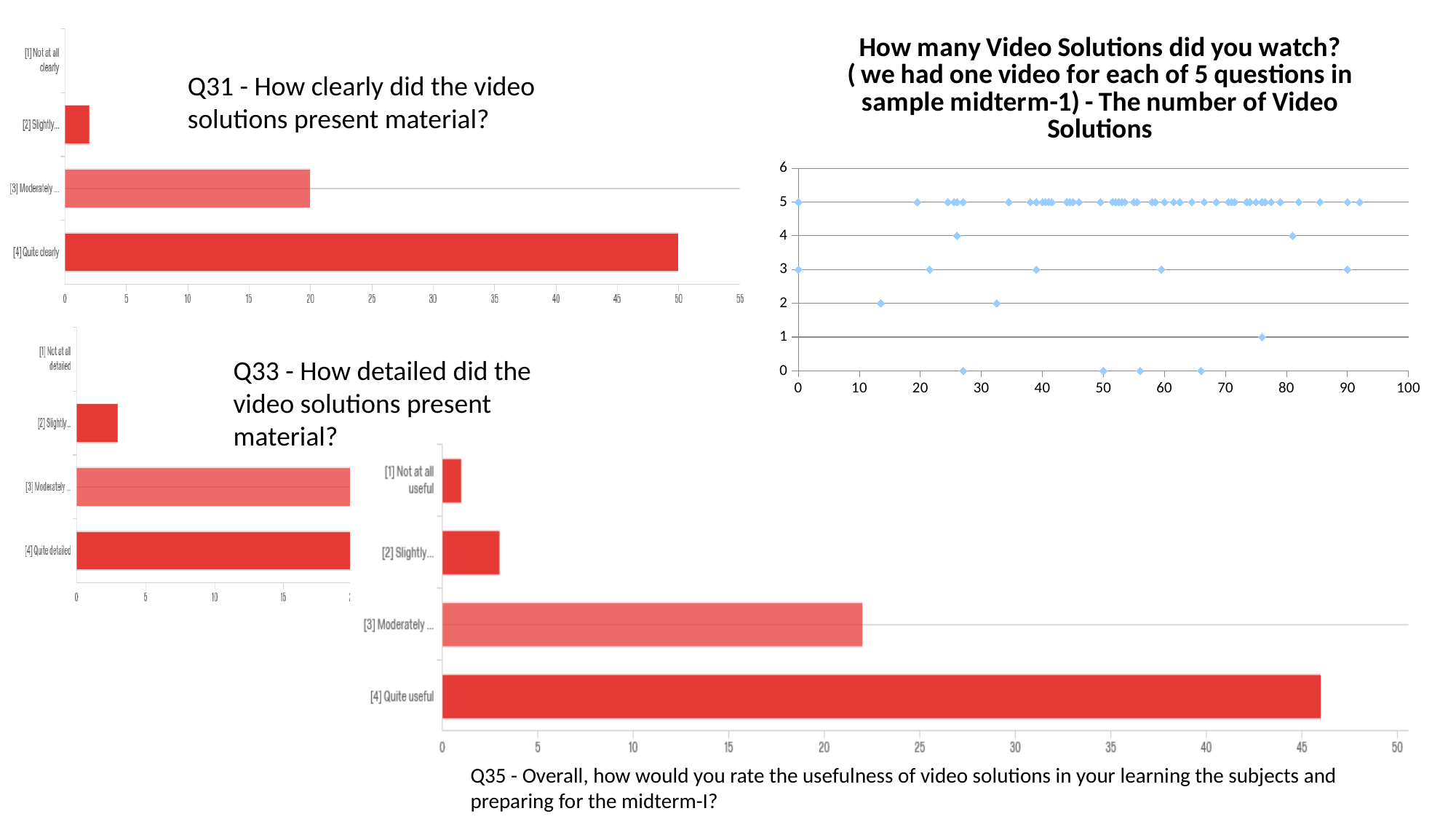
In the Q31 chart (How clearly did the video solutions present material?), what is the value for [3] Moderately? 20 In the Q35 chart (Overall, how would you rate the usefulness of video solutions), is the value for [3] Moderately greater or less than 25? less In the Q35 chart (Overall, how would you rate the usefulness of video solutions), which category has the lowest value? [1] Not at all useful In the Q31 chart (How clearly did the video solutions present material?), what is the difference between the values for [4] Quite clearly and [3] Moderately? 30 In the Q31 chart (How clearly did the video solutions present material?), what is the value for [4] Quite clearly? 50 In the Q35 chart (Overall, how would you rate the usefulness of video solutions), how many categories are shown? 4 In the Q35 chart (Overall, how would you rate the usefulness of video solutions), is the value for [4] Quite useful greater or less than 45? greater In the Q31 chart (How clearly did the video solutions present material?), which category has the highest value? [4] Quite clearly In the Q35 chart (Overall, how would you rate the usefulness of video solutions), which category has the highest value? [4] Quite useful What kind of chart is the Q31 chart (How clearly did the video solutions present material?)? bar chart In the Q31 chart (How clearly did the video solutions present material?), is the value for [2] Slightly greater or less than 5? less What kind of chart is the chart titled 'How many Video Solutions did you watch?'? scatter chart